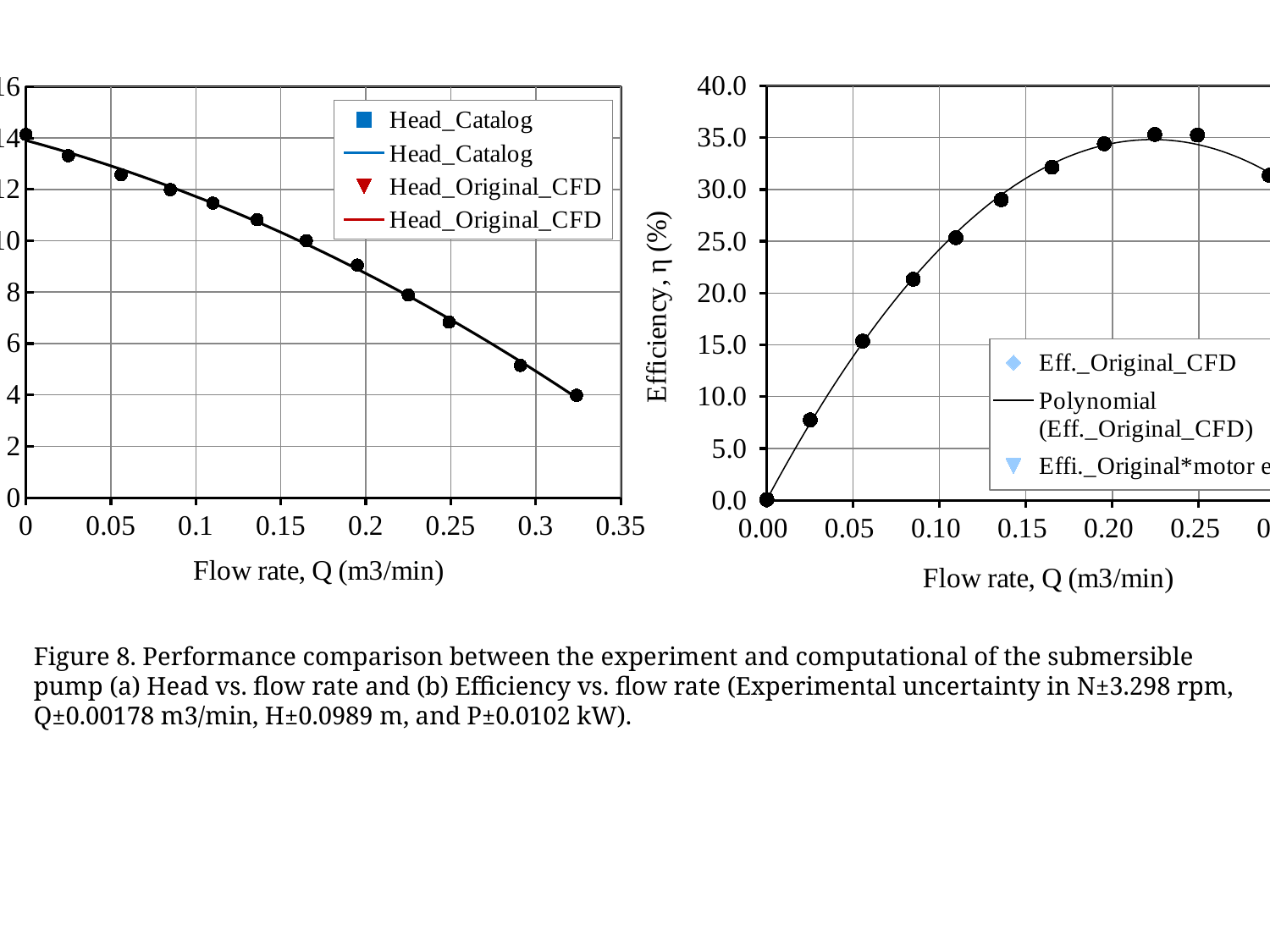
On the right chart (Efficiency vs. flow rate), is the efficiency at a flow rate of about 0.165 greater or less than 30.0? greater On the right chart (Efficiency vs. flow rate), what is the efficiency at a flow rate of 0.00? 0.0 On the left chart (Head vs. flow rate), is the head highest at the lowest or the highest flow rate? lowest flow rate On the left chart (Head vs. flow rate), is the head at a flow rate of about 0.11 greater or less than 10? greater On the right chart (Efficiency vs. flow rate), is the efficiency at a flow rate of about 0.055 greater or less than 10.0? greater How many series does the legend of the left chart (Head vs. flow rate) list? 4 On the left chart (Head vs. flow rate), do the head values rise or fall as flow rate increases? fall What kind of chart is the left chart (Head vs. flow rate)? line chart What is the y-axis title of the right chart? Efficiency, η (%) How many data points are plotted on the left chart (Head vs. flow rate)? 12 On the right chart (Efficiency vs. flow rate), does efficiency rise or fall as flow rate increases from 0.00 to 0.20? rise